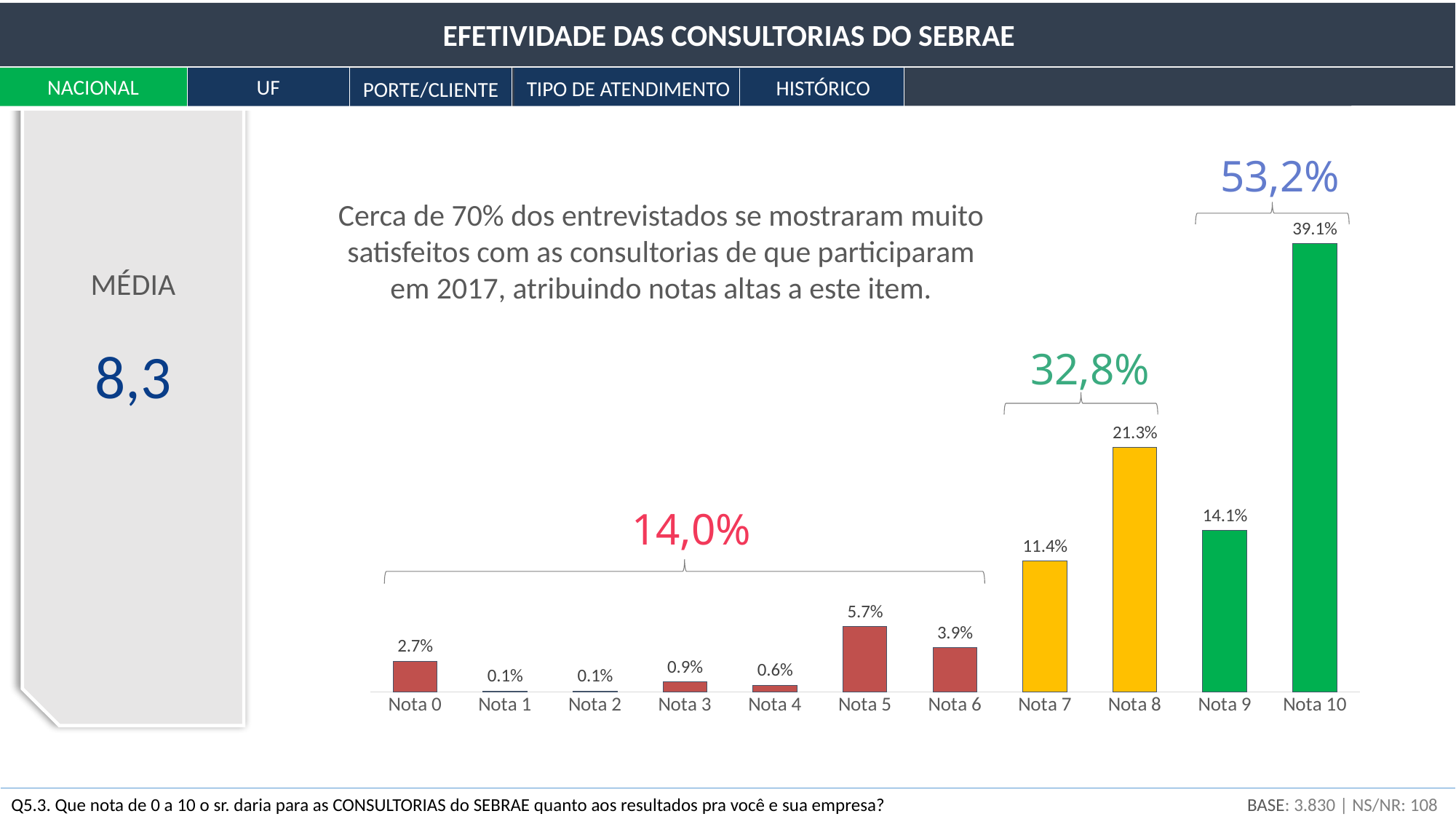
Which is larger, the value for Nota 9 or the value for Nota 7? Nota 9 What kind of chart is shown on the slide? Bar chart What is the combined share shown for Nota 7 and Nota 8 (the bracket label above them)? 32,8% Which category has the highest value? Nota 10 How many categories are shown on the x axis? 11 What is the combined share shown for Nota 0 through Nota 6 (the bracket label above them)? 14,0% Which category has the lowest value among Nota 0, Nota 3, Nota 4 and Nota 5? Nota 4 What is the average (MÉDIA) shown on the left of the slide? 8,3 What is the value for Nota 8? 21.3% What is the value for Nota 10? 39.1% What is the difference between the values for Nota 10 and Nota 8? 17.8% What is the value for Nota 5? 5.7%